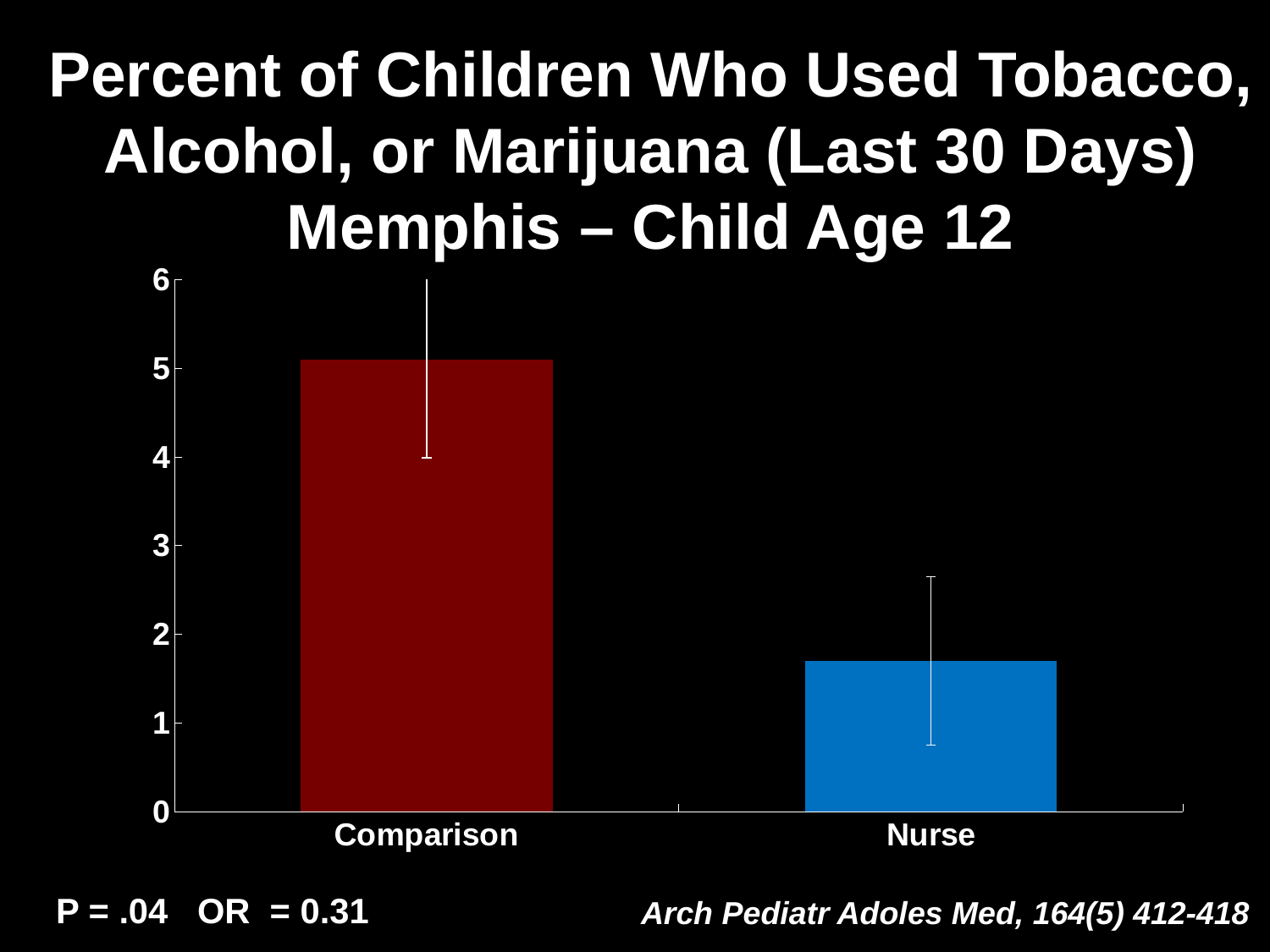
Which category has the lowest bar? Nurse Which is larger, the value for Comparison or the value for Nurse? Comparison Which category has the highest bar? Comparison What kind of chart is shown on the slide? bar chart Is the value for Comparison greater or less than 4? greater What is the highest value shown on the y axis? 6 What colour is the bar for Nurse? blue Is the value for Comparison greater or less than 6? less Is the value for Nurse greater or less than 1? greater How many categories are plotted on the x axis? 2